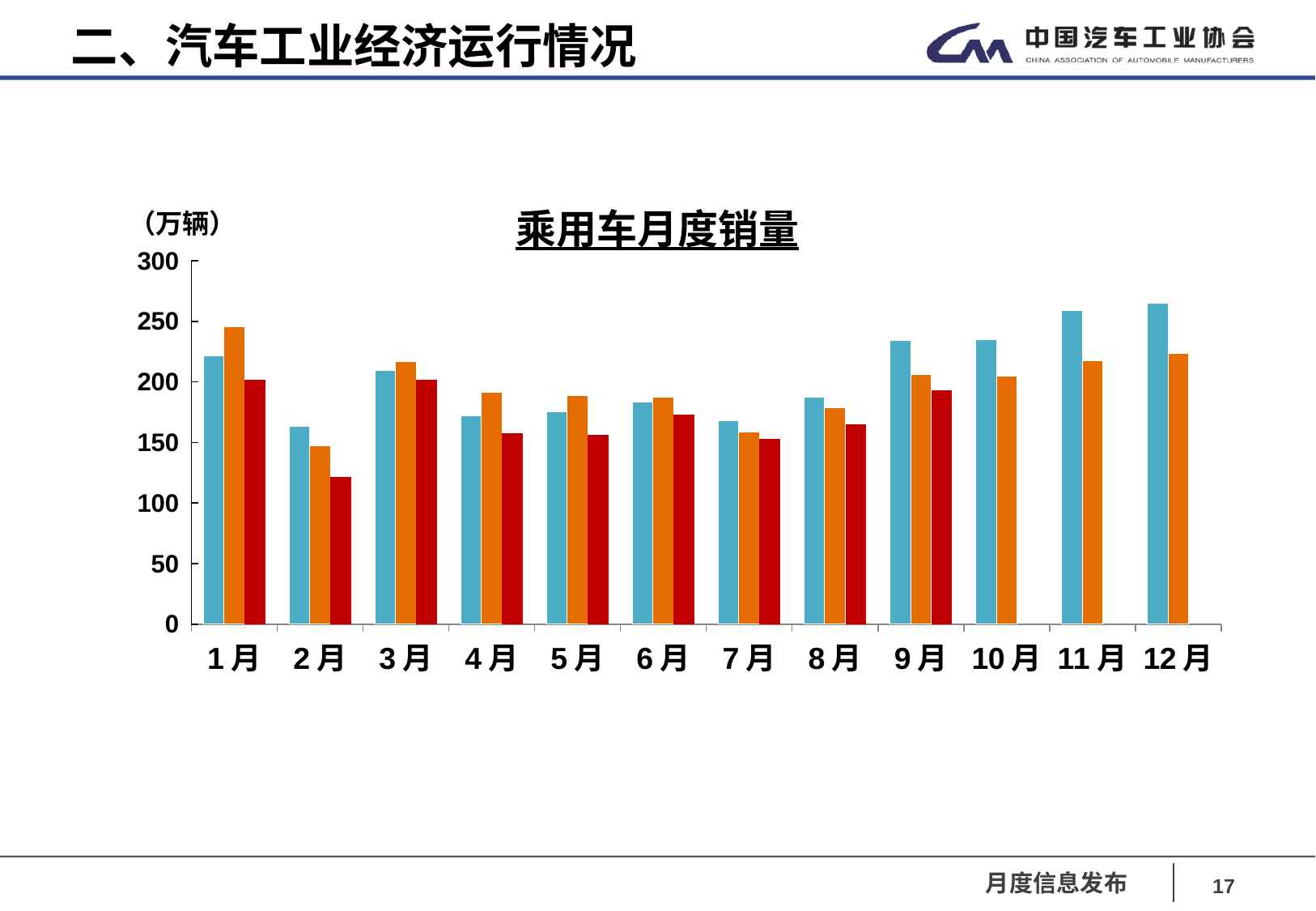
Is the value of the red bar for 2月 greater or less than 150? less Is the value of the orange bar for 7月 greater or less than 200? less Among the blue bars, which month has the highest value? 12月 For 1月, which is larger: the blue bar or the orange bar? the orange bar What kind of chart is shown on the slide? bar chart Among the red bars, which month has the lowest value? 2月 Is the value of the orange bar for 1月 greater or less than 200? greater How many months are shown on the x axis of the chart? 12 What is the title of the chart? 乘用车月度销量 Among the orange bars, which month has the highest value? 1月 What unit is shown for the y axis of the chart? 万辆